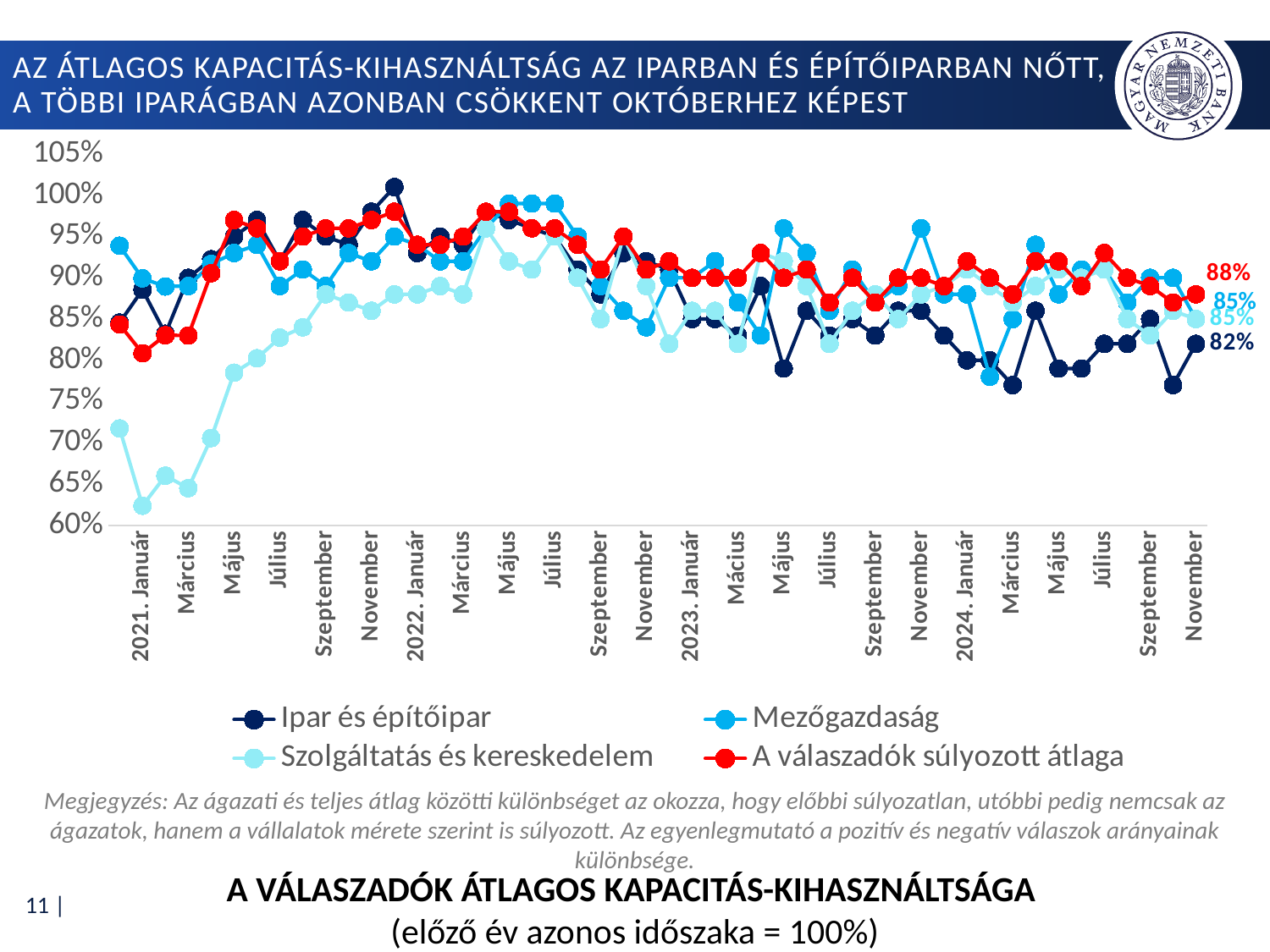
Is the value for 'Szolgáltatás és kereskedelem' in 2021. Január greater or less than 75%? less Which series has the highest value at the last point (November 2024)? A válaszadók súlyozott átlaga What is the difference between the final values of 'A válaszadók súlyozott átlaga' (88%) and 'Ipar és építőipar' (82%)? 6 percentage points What is the value of 'Ipar és építőipar' at the last point (November 2024)? 82% How many series does the legend list? 4 What kind of chart is shown on the slide? Line chart Which series has the lowest value at the last point (November 2024)? Ipar és építőipar What is the value of 'Mezőgazdaság' at the last point (November 2024)? 85% What colour is the line for 'A válaszadók súlyozott átlaga'? Red What is the value of 'A válaszadók súlyozott átlaga' at the last point (November 2024)? 88% Does the 'Szolgáltatás és kereskedelem' series rise or fall between 2021. Január and 2022. Május? rise